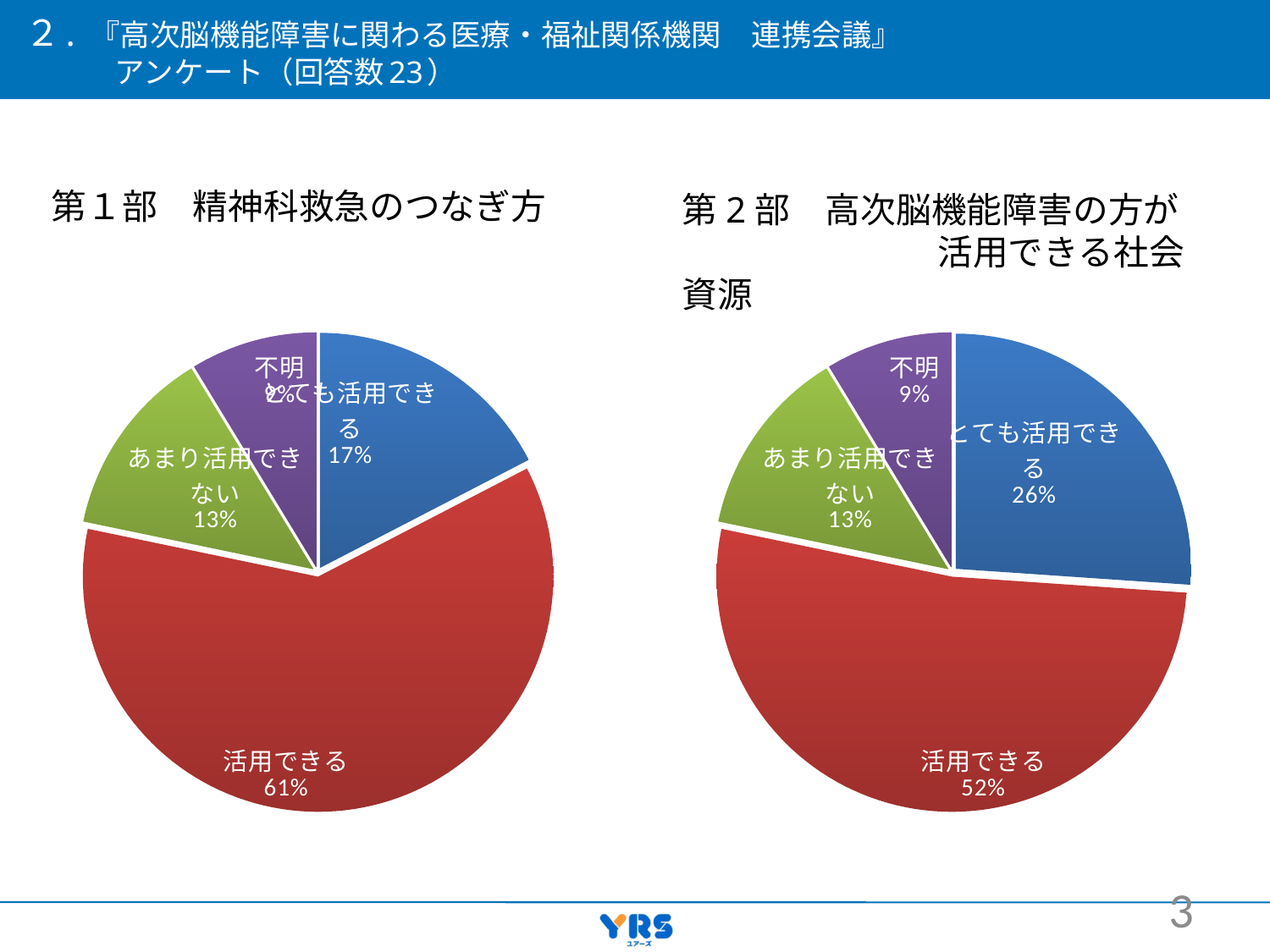
In the right pie chart (第2部 高次脳機能障害の方が活用できる社会資源), what is the difference in percentage points between 活用できる and とても活用できる? 26 In the left pie chart (第1部 精神科救急のつなぎ方), which is larger: とても活用できる or あまり活用できない? とても活用できる In the right pie chart (第2部 高次脳機能障害の方が活用できる社会資源), what percentage is shown for 不明? 9% In the right pie chart (第2部 高次脳機能障害の方が活用できる社会資源), what percentage is shown for 活用できる? 52% In the right pie chart (第2部 高次脳機能障害の方が活用できる社会資源), what percentage is shown for とても活用できる? 26% In the left pie chart (第1部 精神科救急のつなぎ方), what percentage is shown for あまり活用できない? 13% In the left pie chart (第1部 精神科救急のつなぎ方), which category has the largest slice? 活用できる What type of chart is used on the left side of the slide (第1部 精神科救急のつなぎ方)? Pie chart In the right pie chart (第2部 高次脳機能障害の方が活用できる社会資源), which category has the smallest slice? 不明 How many slices does the right pie chart (第2部 高次脳機能障害の方が活用できる社会資源) have? 4 In the left pie chart (第1部 精神科救急のつなぎ方), what percentage is shown for とても活用できる? 17% In the left pie chart (第1部 精神科救急のつなぎ方), what percentage is shown for 活用できる? 61%